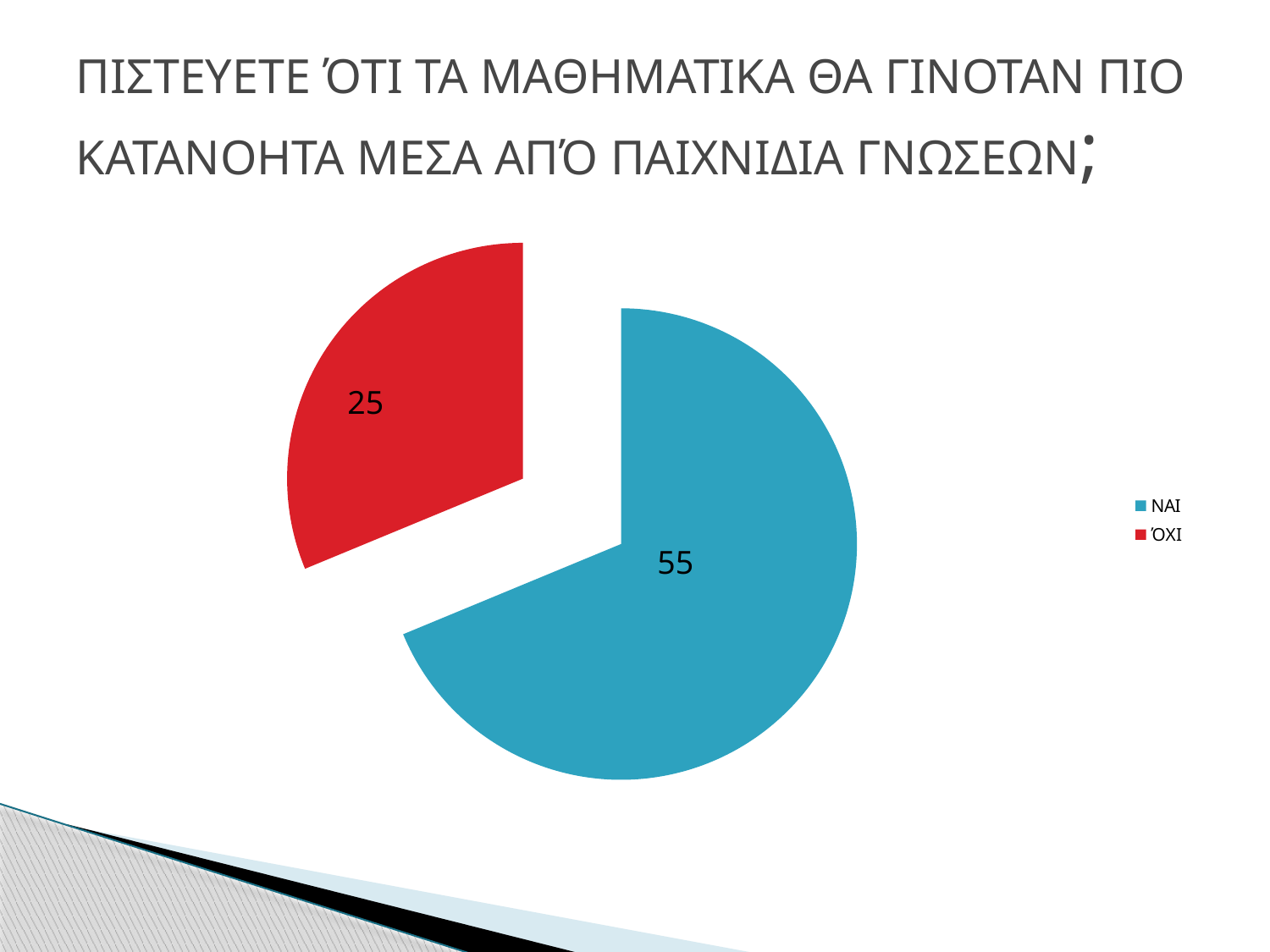
What share of the pie does the ΝΑΙ slice represent? 68.75% How many slices does the pie chart have? 2 What is the value for ΝΑΙ in the pie chart? 55 What is the total of all slices in the pie chart? 80 What is the value for ΌΧΙ in the pie chart? 25 What colour is the ΌΧΙ slice in the pie chart? red How many entries does the legend list? 2 Which is larger, the value for ΝΑΙ or the value for ΌΧΙ? ΝΑΙ Which category has the largest slice in the pie chart? ΝΑΙ What type of chart is shown on the slide? pie chart Which category has the smallest slice in the pie chart? ΌΧΙ What is the difference between the values for ΝΑΙ and ΌΧΙ? 30